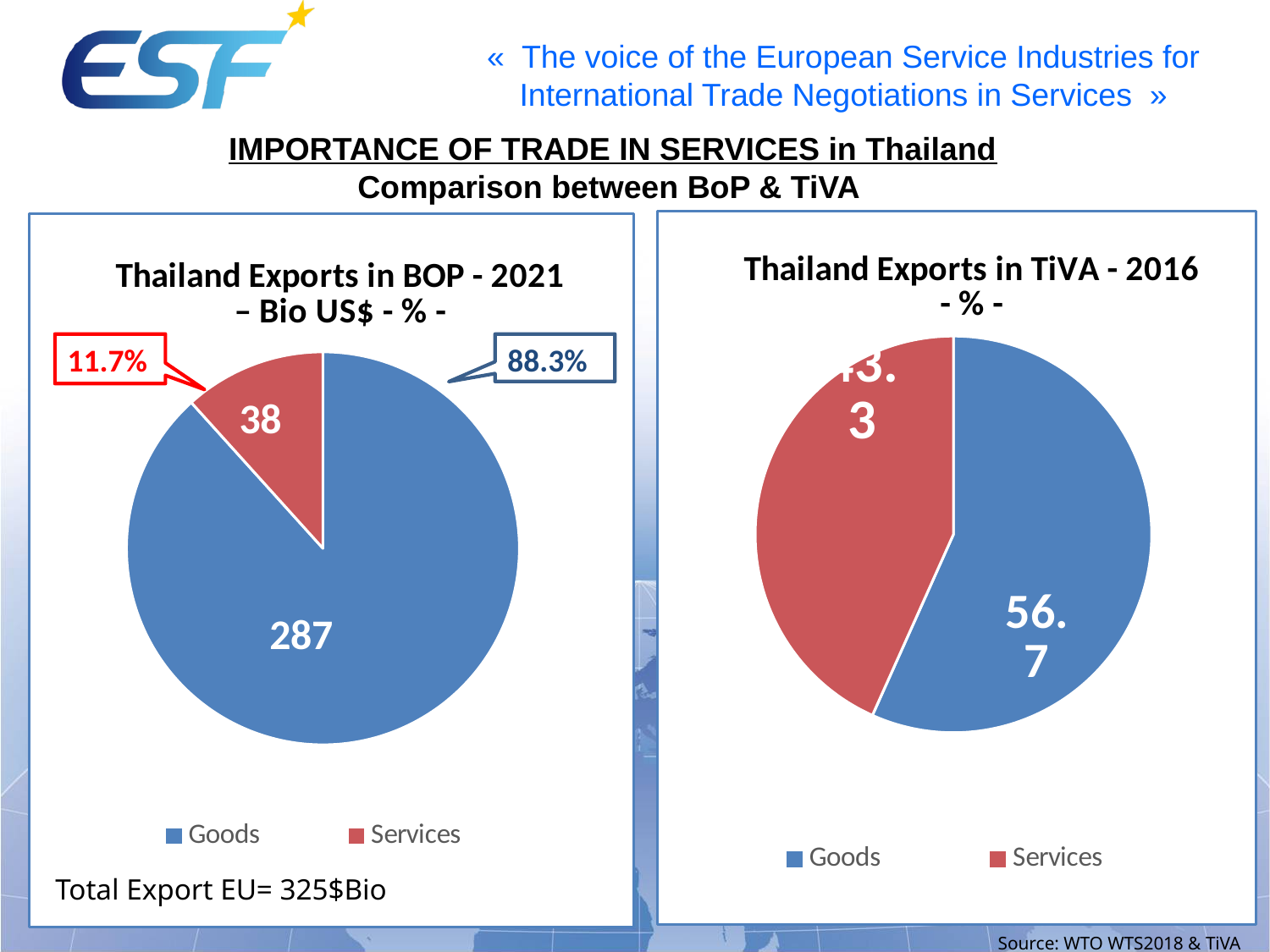
In the 'Thailand Exports in TiVA - 2016' chart, what colour represents Services? Red In the 'Thailand Exports in BOP - 2021' chart, which category is the largest? Goods In the 'Thailand Exports in BOP - 2021' chart, what is the difference between the Goods and Services values? 249 In the 'Thailand Exports in BOP - 2021' chart, what is the value for Services? 38 In the 'Thailand Exports in BOP - 2021' chart, what percentage share is shown for Services? 11.7% How many categories does the legend of the 'Thailand Exports in BOP - 2021' chart list? 2 In the 'Thailand Exports in TiVA - 2016' chart, which is larger, Goods or Services? Goods In the 'Thailand Exports in BOP - 2021' chart, what percentage share is shown for Goods? 88.3% In the 'Thailand Exports in BOP - 2021' chart, what is the value for Goods? 287 In the 'Thailand Exports in BOP - 2021' chart, what is the total of the Goods and Services values? 325 In the 'Thailand Exports in TiVA - 2016' chart, what is the value for Goods? 56.7 What kind of chart is 'Thailand Exports in TiVA - 2016'? Pie chart